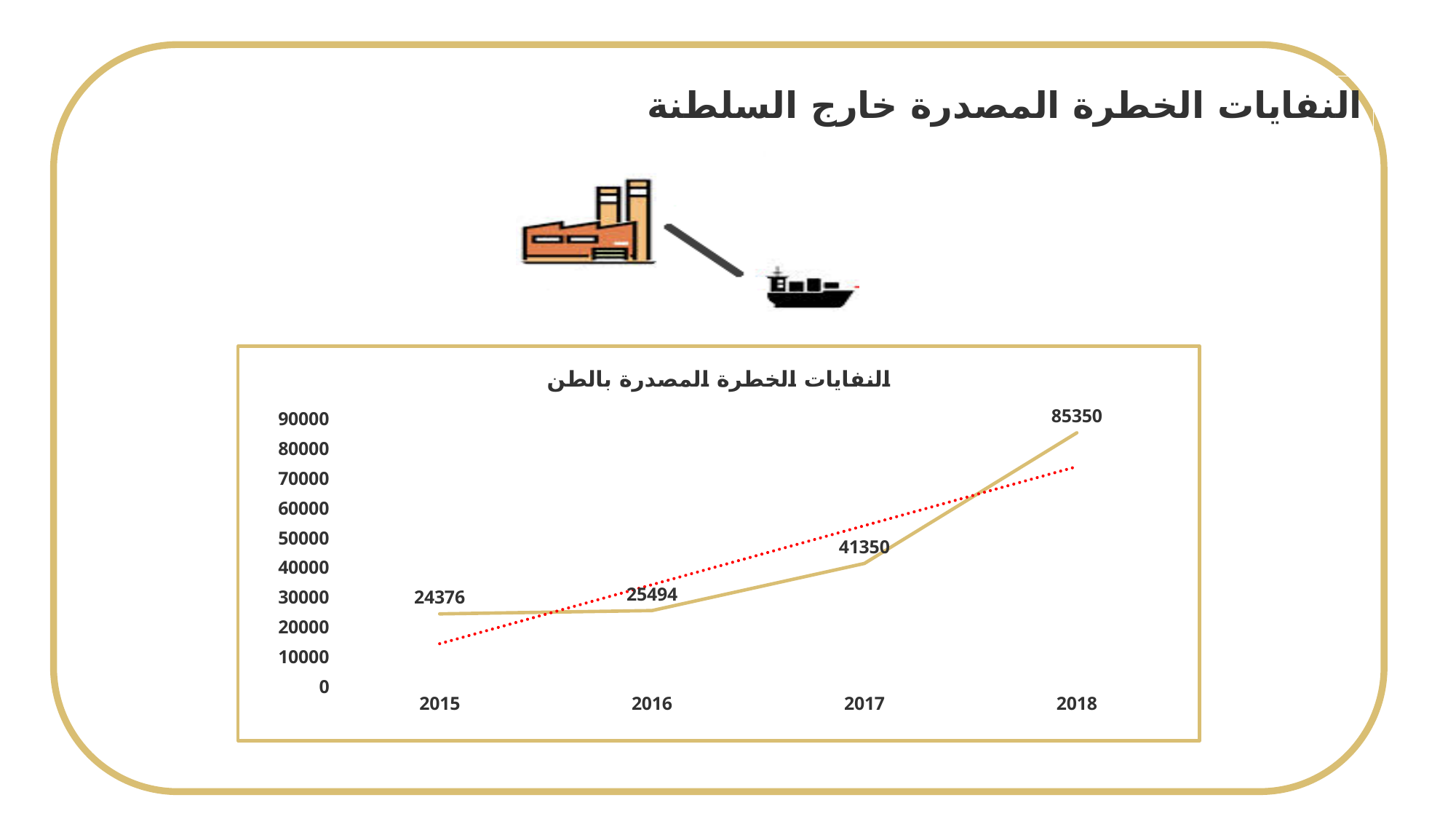
Do the values rise or fall from 2015 to 2018? rise What is the value for 2017? 41350 Which year has the lowest value? 2015 What is the value for 2015? 24376 What is the value for 2018? 85350 What is the value for 2016? 25494 Which is larger, the value for 2017 or the value for 2016? 2017 How many years are plotted on the x axis? 4 Which year has the highest value? 2018 What kind of chart is shown? line chart What is the difference between the values for 2016 and 2015? 1118 What is the difference between the values for 2018 and 2017? 44000